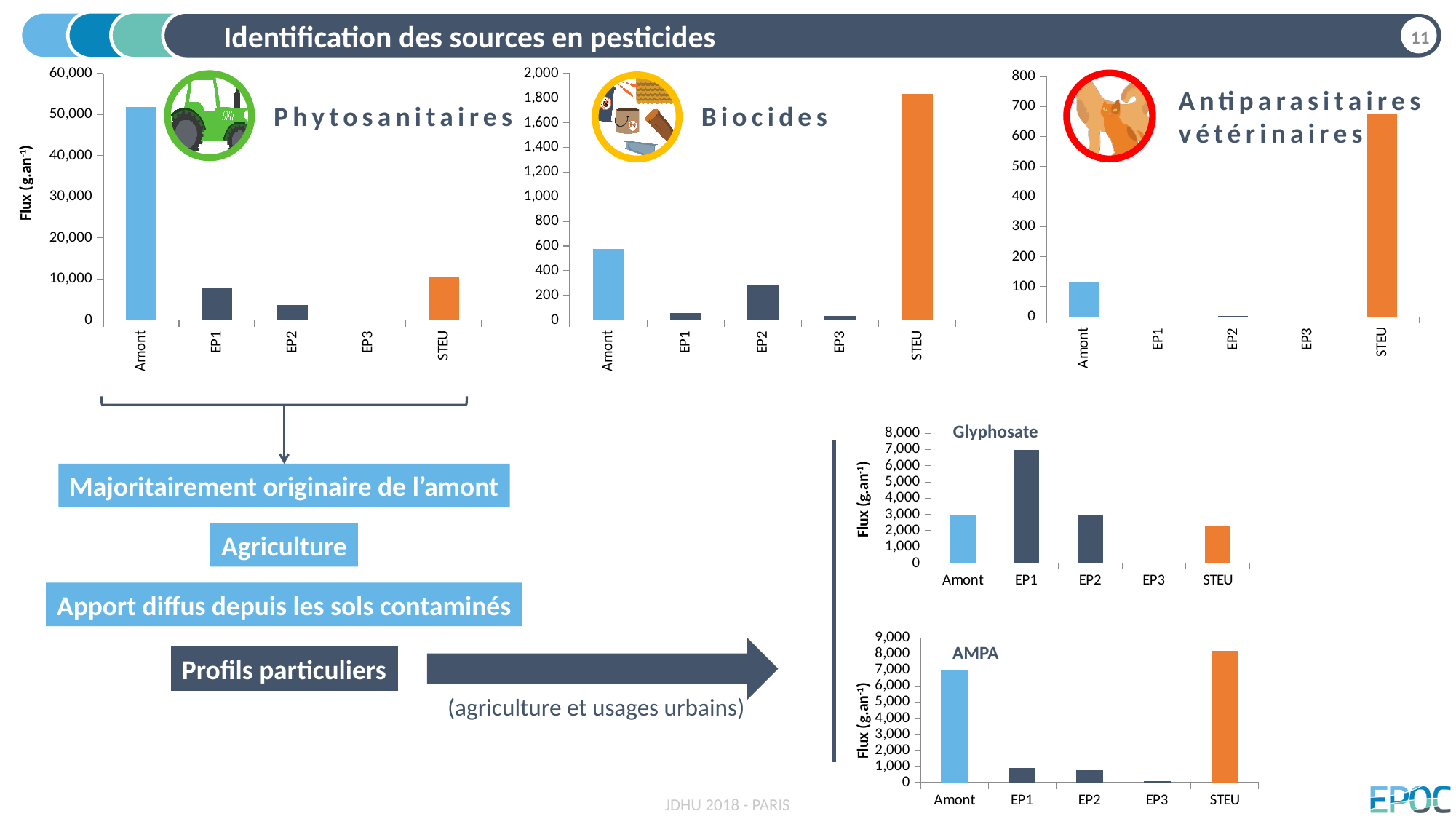
In the Biocides chart, which category has the highest value? STEU In the Antiparasitaires vétérinaires chart, which is larger, the value for Amont or the value for EP2? Amont In the Glyphosate chart, is the value for STEU greater or less than 3,000? less In the Antiparasitaires vétérinaires chart, is the value for STEU greater or less than 600? greater In the AMPA chart, which is larger, the value for STEU or the value for Amont? STEU In the Biocides chart, which is larger, the value for Amont or the value for EP2? Amont In the Phytosanitaires chart, is the value for EP1 greater or less than 10,000? less In the Phytosanitaires chart, which category has the highest value? Amont In the Glyphosate chart, which category has the highest value? EP1 How many categories are shown on the x axis of the AMPA chart? 5